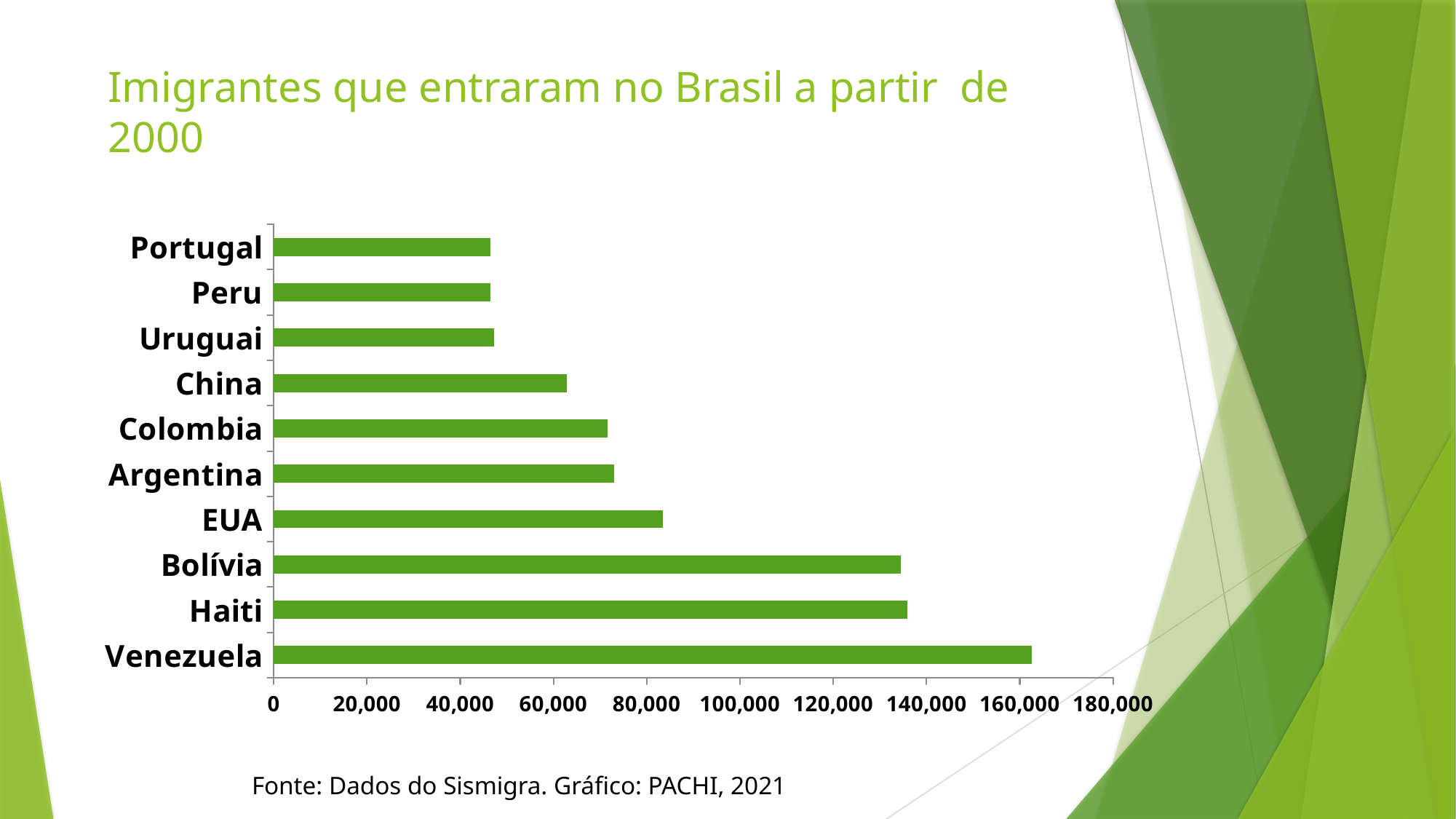
Is the value for Portugal greater or less than 40,000? greater Which country has the highest number of immigrants in the chart? Venezuela Is the value for Bolívia greater or less than 120,000? greater Is the value for EUA greater or less than 100,000? less What is the title of the slide containing the chart? Imigrantes que entraram no Brasil a partir de 2000 What kind of chart is shown on the slide? bar chart How many countries are shown in the chart? 10 Which has a larger value, Venezuela or Haiti? Venezuela Which has a larger value, EUA or China? EUA Which has a larger value, Bolívia or EUA? Bolívia